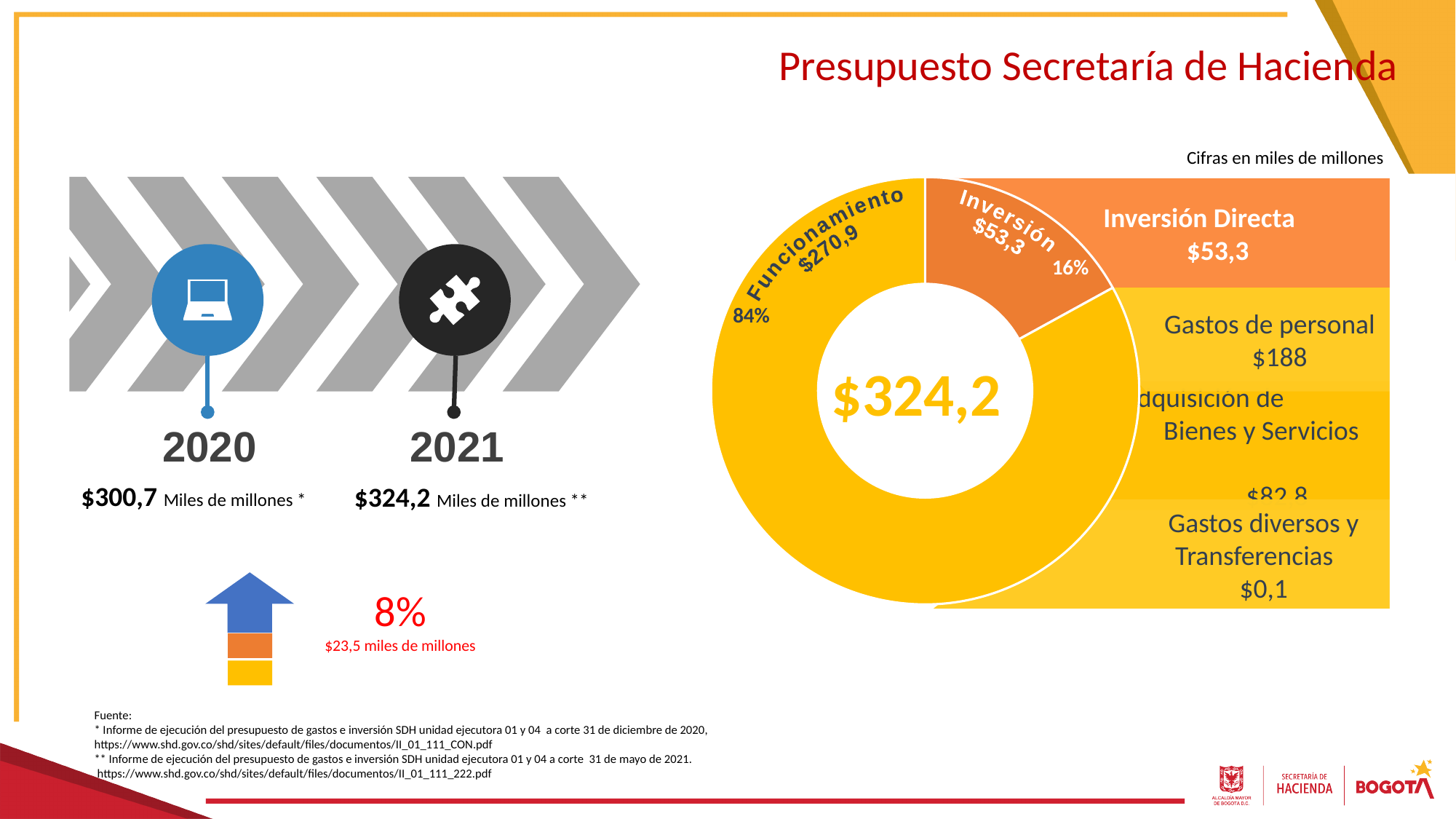
What share of the donut chart does Inversión represent? 16% What total value is shown in the center of the donut chart? $324,2 What is the value shown for Funcionamiento in the donut chart? $270,9 What share of the donut chart does Funcionamiento represent? 84% What is the value shown for Inversión in the donut chart? $53,3 In the breakdown next to the donut chart, what is the value for Gastos de personal? $188 How many slices does the donut chart have? 2 Which slice of the donut chart is the largest? Funcionamiento What is the difference between the Funcionamiento and Inversión values in the donut chart? $217,6 What kind of chart is shown on the right side of the slide? donut (pie) chart Which slice of the donut chart is the smallest? Inversión In the breakdown next to the donut chart, what is the value for Gastos diversos y Transferencias? $0,1